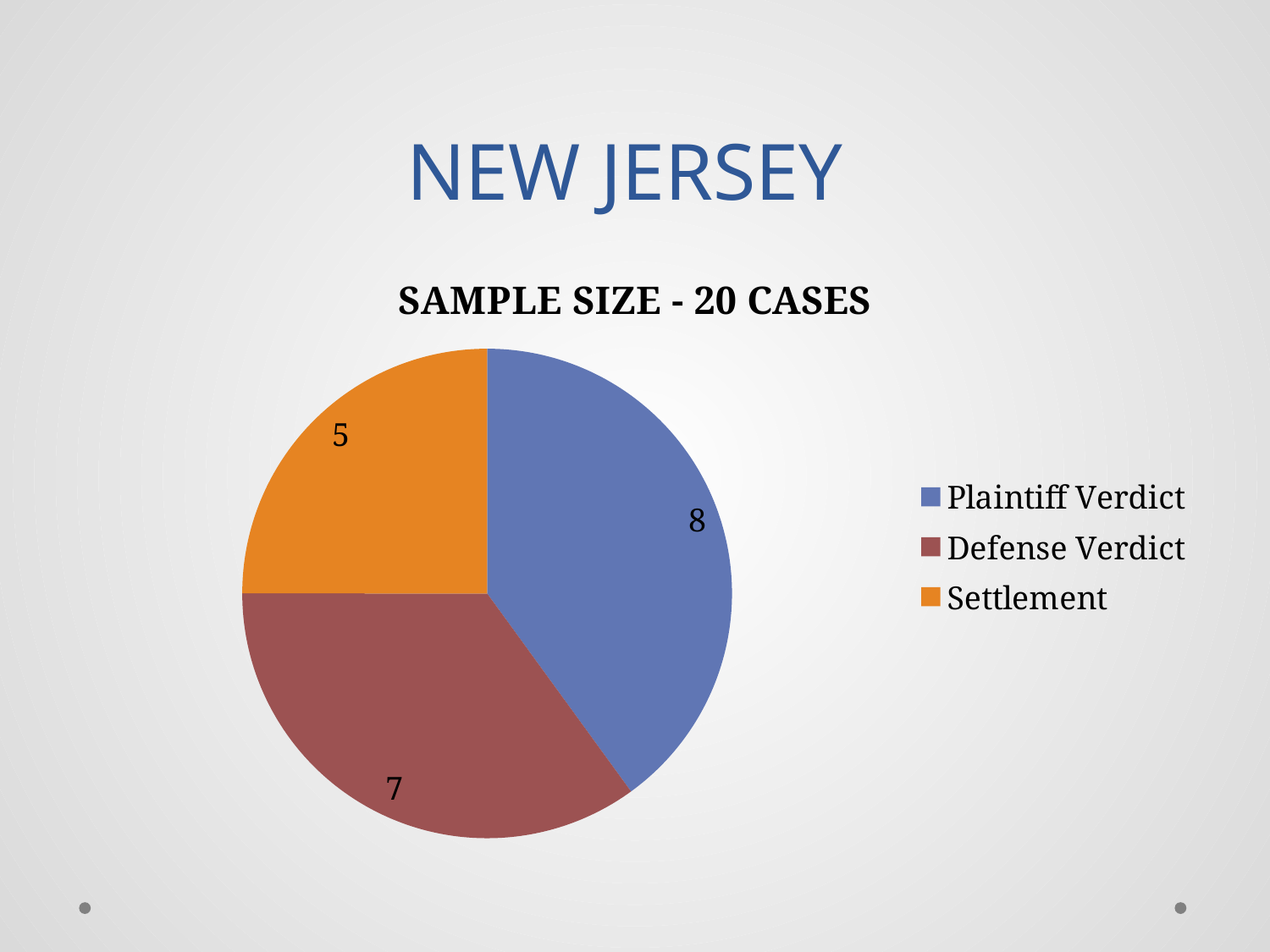
Which category has the largest slice? Plaintiff Verdict How many cases are Defense Verdict? 7 What colour is the Settlement slice? orange What is the difference between the Plaintiff Verdict and Settlement values? 3 How many categories does the pie chart have? 3 What kind of chart is shown on the slide? pie chart Which category has the smallest slice? Settlement How many cases are Settlement? 5 What is the chart's title? SAMPLE SIZE - 20 CASES How many cases are Plaintiff Verdict? 8 What share of the pie does Settlement represent? 25% Which is larger, Defense Verdict or Settlement? Defense Verdict